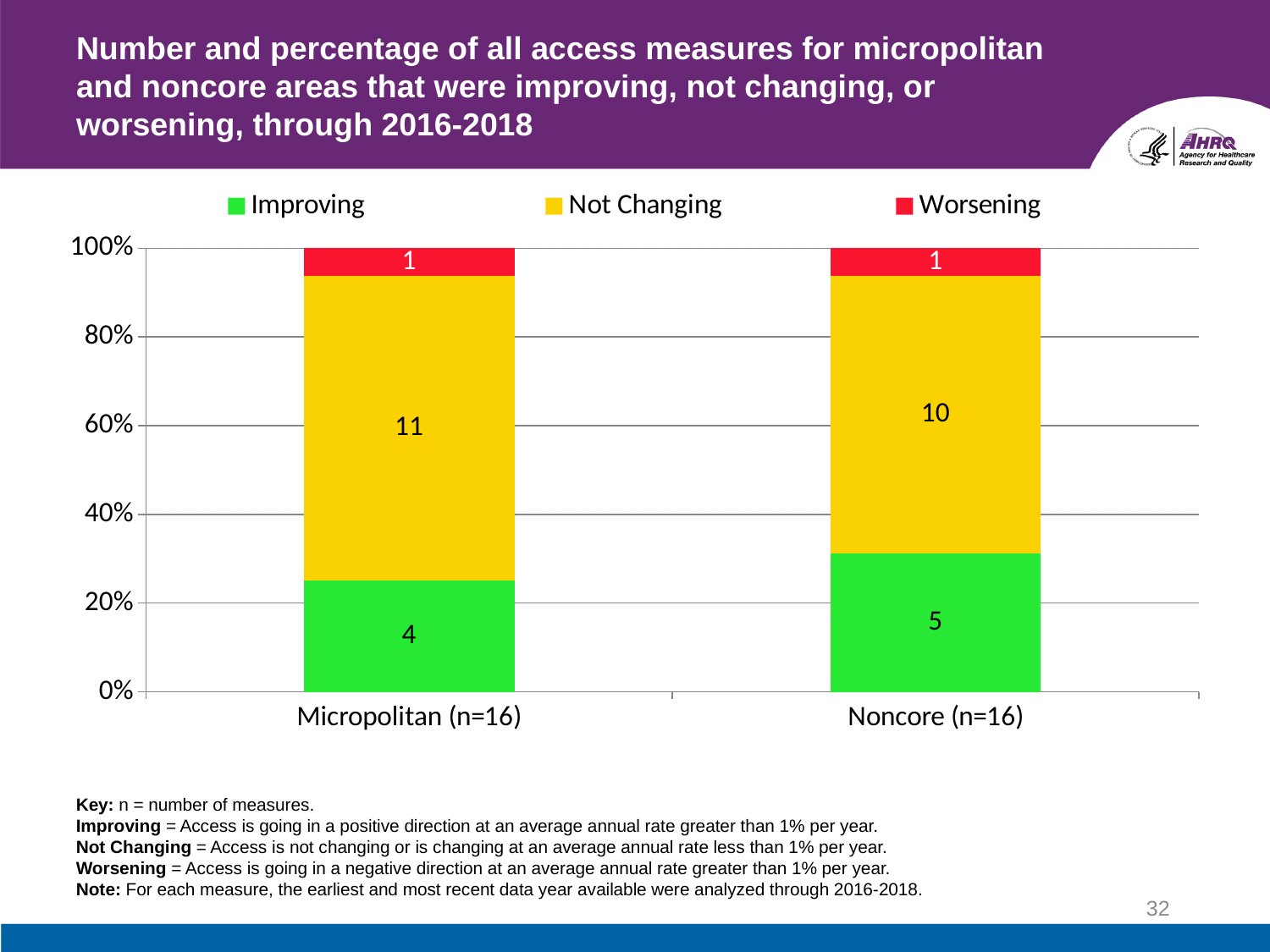
What kind of chart is shown on the slide? Stacked bar chart How many access measures were Not Changing for Noncore (n=16)? 10 Which category has the higher number of Not Changing measures, Micropolitan (n=16) or Noncore (n=16)? Micropolitan (n=16) What is the total number of measures in the Noncore (n=16) stacked bar? 16 How many access measures were Improving for Micropolitan (n=16)? 4 How many access measures were Improving for Noncore (n=16)? 5 What is the difference between the number of Not Changing measures for Micropolitan (n=16) and Noncore (n=16)? 1 Is the Improving share for Noncore (n=16) greater or less than 40%? less How many access measures were Worsening for Micropolitan (n=16)? 1 Which colour represents the Worsening series in the chart? Red How many categories are shown on the x axis? 2 How many series does the legend list? 3